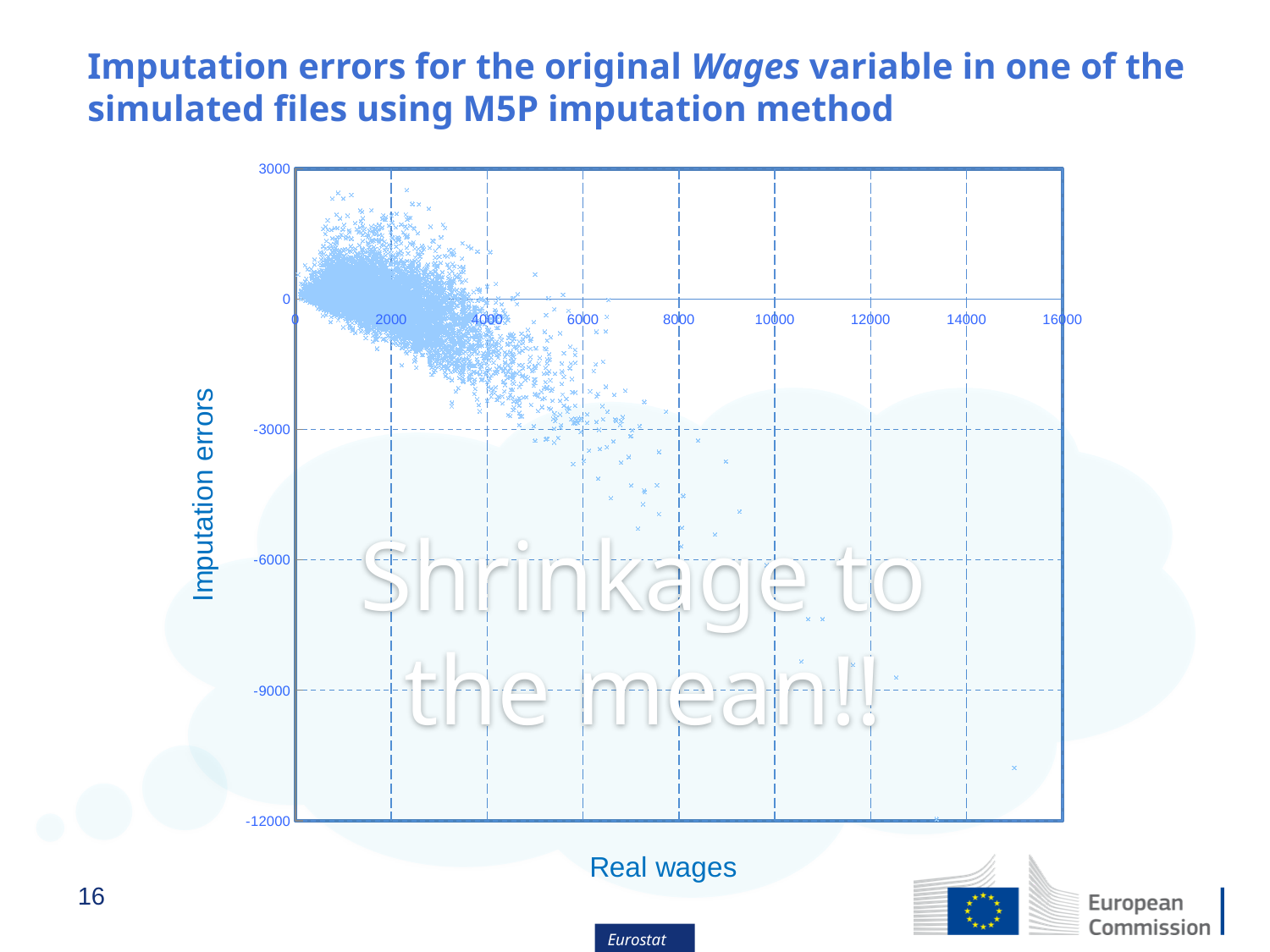
What kind of chart is shown on the slide? scatter chart As real wages increase along the x axis, do the imputation errors generally rise or fall? fall What is the label of the x axis of the chart? Real wages Is the lowest imputation error plotted on the chart greater or less than -9000? less What is the label of the y axis of the chart? Imputation errors Are the imputation errors for most of the plotted points greater or less than -3000? greater Is the largest real wage value plotted on the chart greater or less than 14000? greater